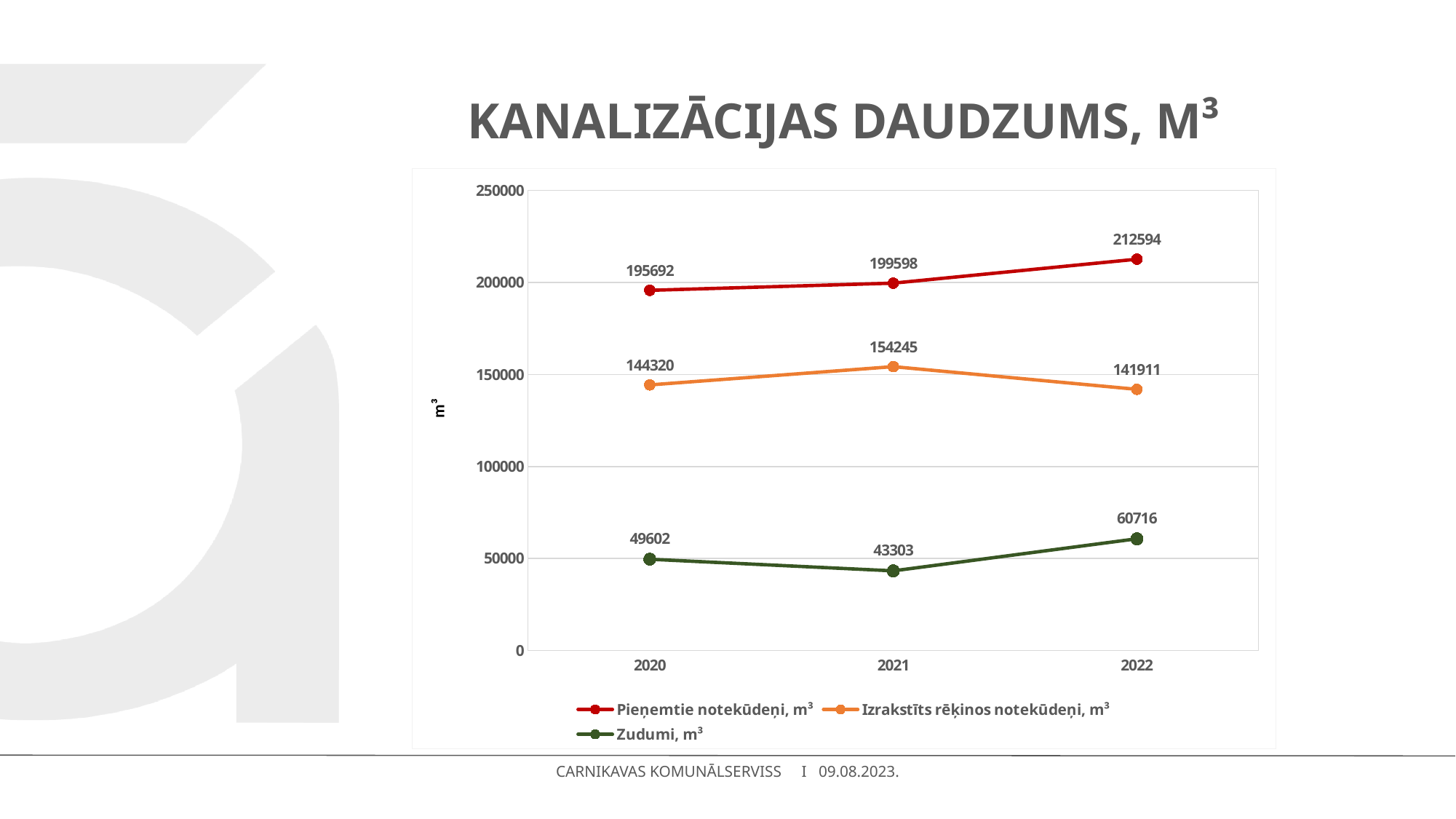
What is the value for Izrakstīts rēķinos notekūdeņi, m³ in 2021? 154245 How many series does the legend list? 3 What is the difference between the Pieņemtie notekūdeņi, m³ values for 2022 and 2020? 16902 Does the Pieņemtie notekūdeņi, m³ series rise or fall from 2020 to 2022? rise What is the value for Pieņemtie notekūdeņi, m³ in 2022? 212594 What is the value for Zudumi, m³ in 2020? 49602 How many years are shown on the x axis? 3 What is the difference between the Zudumi, m³ values for 2022 and 2021? 17413 Which is larger: Izrakstīts rēķinos notekūdeņi, m³ in 2020 or in 2022? 2020 What type of chart is shown on the slide? line chart In which year is Zudumi, m³ lowest? 2021 In which year is Pieņemtie notekūdeņi, m³ highest? 2022